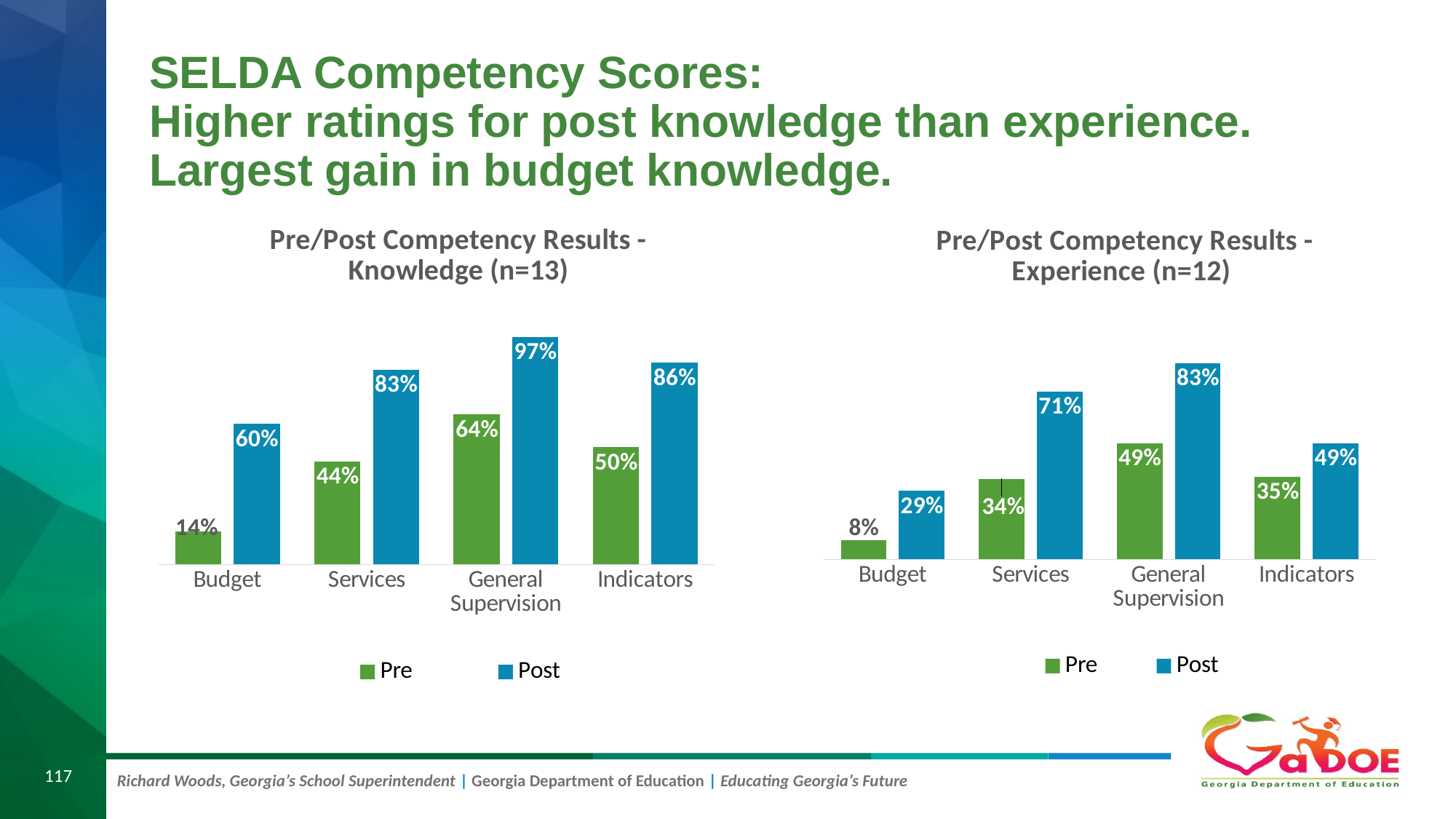
In the 'Pre/Post Competency Results - Knowledge (n=13)' chart, what is the Post value for Budget? 60% In the 'Pre/Post Competency Results - Experience (n=12)' chart, which category has the lowest Pre value? Budget How many categories are shown on the x axis of the 'Pre/Post Competency Results - Knowledge (n=13)' chart? 4 In the 'Pre/Post Competency Results - Experience (n=12)' chart, what is the Pre value for General Supervision? 49% In the 'Pre/Post Competency Results - Knowledge (n=13)' chart, which colour represents the Post series? Blue In the 'Pre/Post Competency Results - Experience (n=12)' chart, what is the Pre value for Services? 34% In the 'Pre/Post Competency Results - Knowledge (n=13)' chart, what is the difference between the Post and Pre values for Budget? 46% How many series does the legend of the 'Pre/Post Competency Results - Experience (n=12)' chart list? 2 Is the Post value for Indicators larger in the Knowledge chart or the Experience chart? Knowledge chart In the 'Pre/Post Competency Results - Experience (n=12)' chart, what is the difference between the Post and Pre values for Services? 37% What kind of chart is the 'Pre/Post Competency Results - Knowledge (n=13)' chart? Bar chart In the 'Pre/Post Competency Results - Knowledge (n=13)' chart, which category has the highest Post value? General Supervision